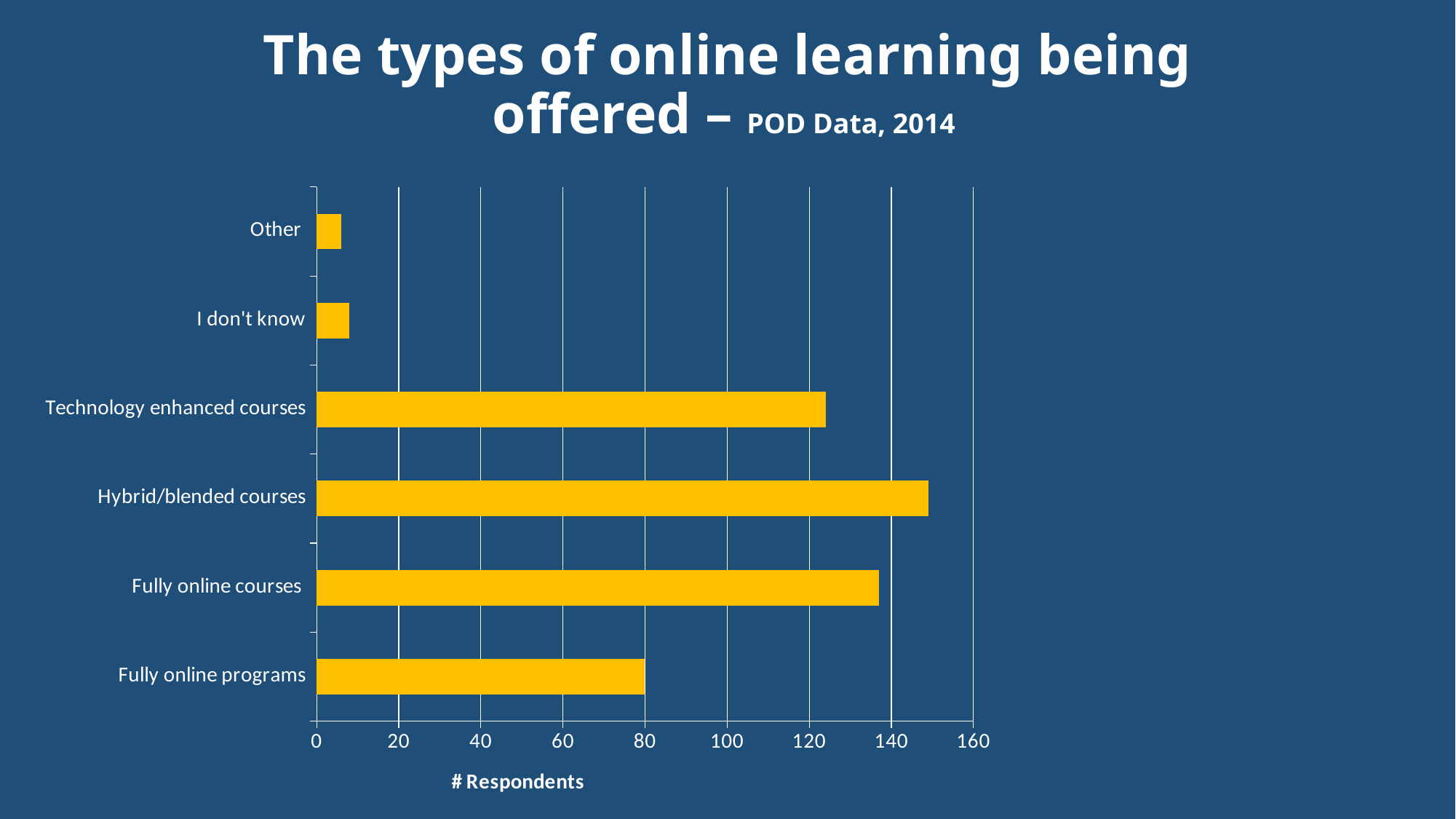
What is the value for Fully online programs? 80 How many categories are plotted in the chart? 6 Is the value for Fully online courses greater or less than 140? less Is the value for Hybrid/blended courses greater or less than 140? greater What is the label of the horizontal axis? # Respondents What kind of chart is shown on the slide? bar chart Which category has the highest number of respondents? Hybrid/blended courses What colour are the bars in the chart? yellow Is the value for Other greater or less than 20? less Which has more respondents, Hybrid/blended courses or Fully online courses? Hybrid/blended courses Which has more respondents, Technology enhanced courses or Fully online programs? Technology enhanced courses